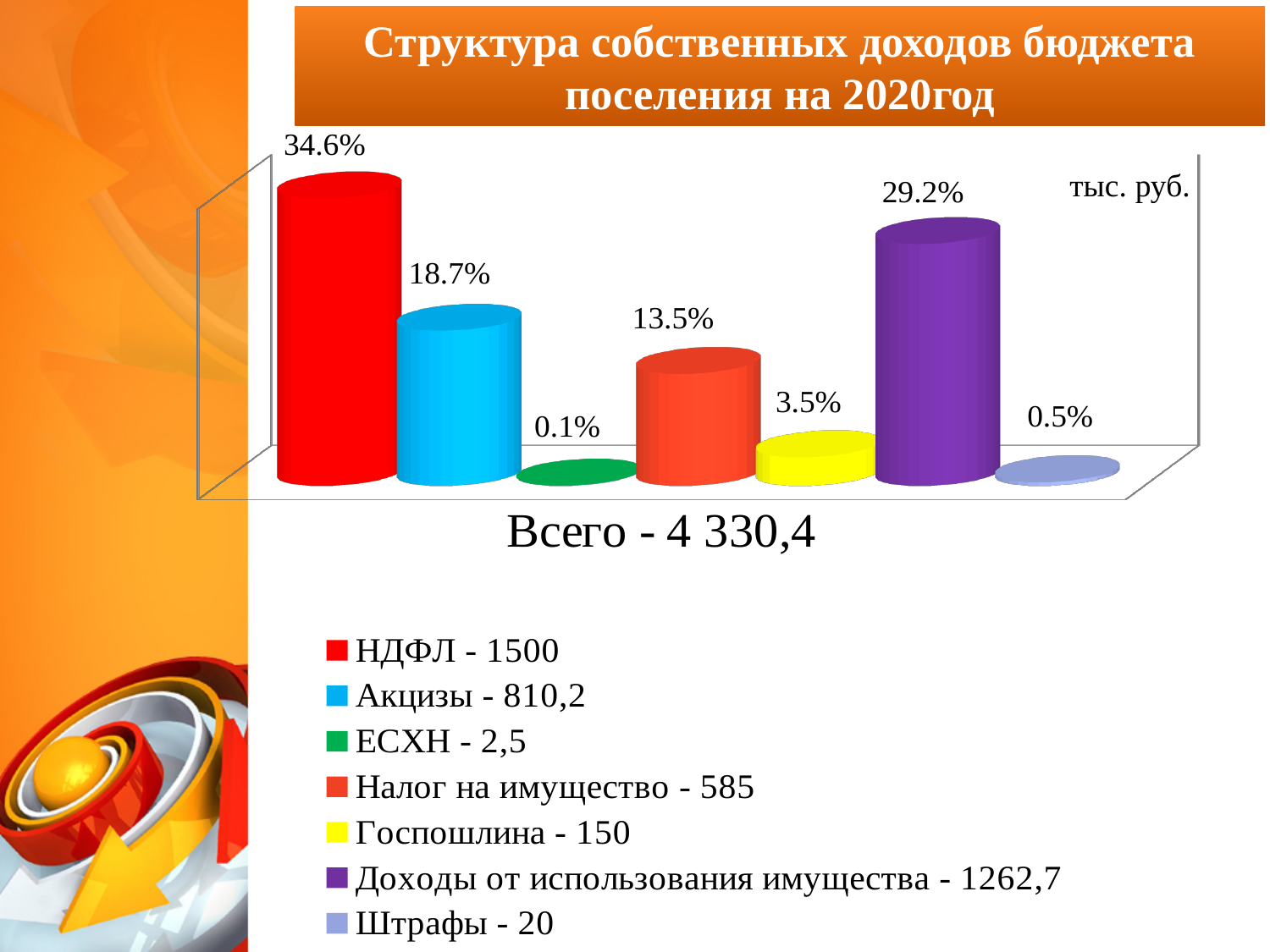
Which category has the lowest share? ЕСХН Which is larger, the share for Акцизы or the share for Налог на имущество? Акцизы How many entries does the legend list? 7 Which category has the highest share? НДФЛ What kind of chart is shown on the slide? Bar chart What is the difference in percentage points between НДФЛ and Доходы от использования имущества? 5.4% What percentage share is shown for Доходы от использования имущества? 29.2% What value in thousand rubles does the legend give for Акцизы? 810,2 What percentage share is shown for Госпошлина? 3.5% What percentage share is shown for НДФЛ? 34.6% How many categories are plotted in the chart? 7 What total (Всего) is stated below the chart? 4 330,4